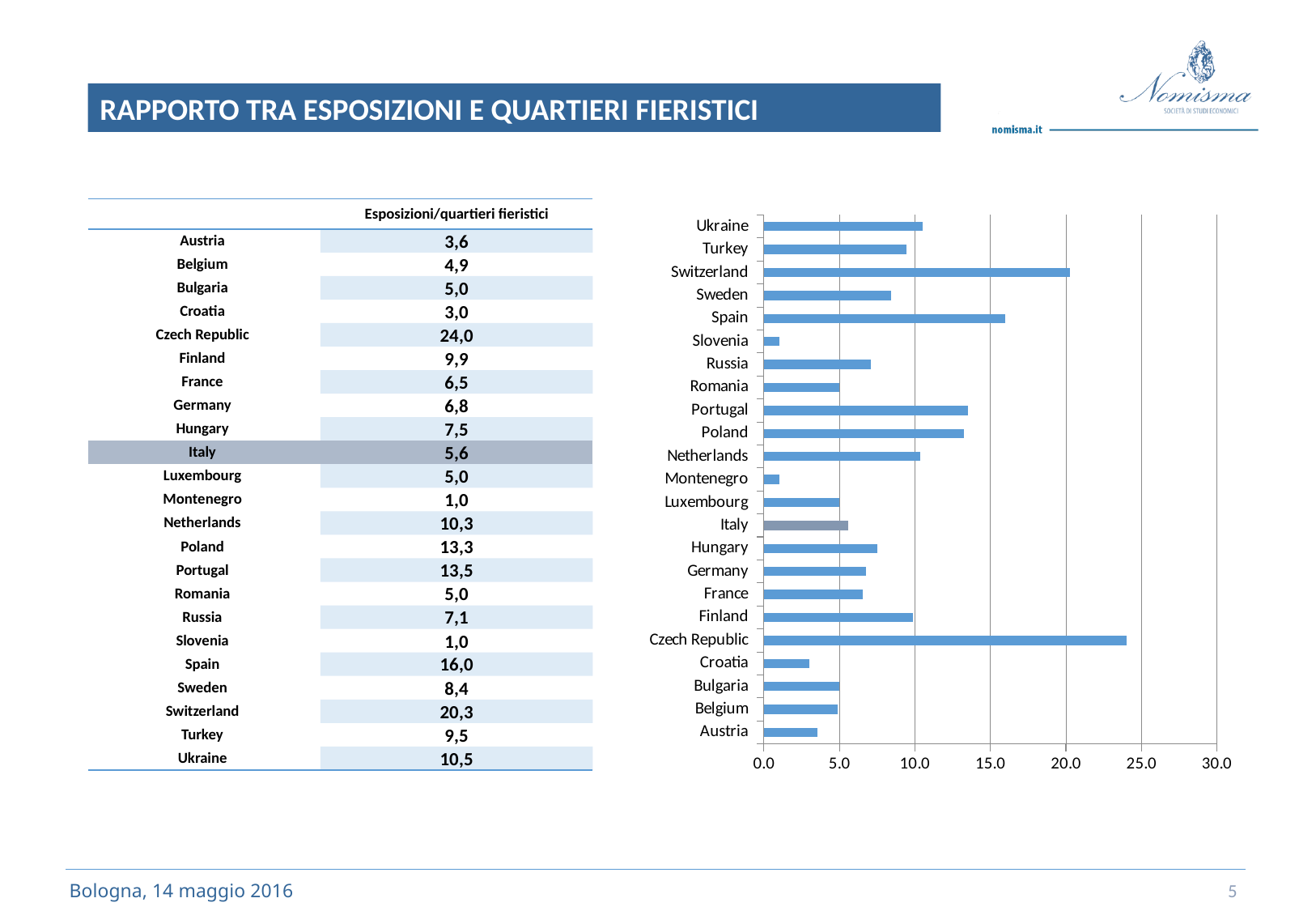
Which country has the highest value in the bar chart? Czech Republic What is the difference between the values for Switzerland and Spain? 4,3 What is the value for Italy? 5,6 What is the value for Czech Republic? 24,0 How many countries are plotted in the bar chart? 23 Is the value for Croatia greater or less than 5.0? less What is the value for Switzerland? 20,3 Which country's bar is shown in a different colour (grey) from the others? Italy What is the maximum value shown on the horizontal axis of the bar chart? 30.0 Is the value for Netherlands greater or less than 10.0? greater What kind of chart is shown on the slide? bar chart Which is larger, the value for Spain or the value for Portugal? Spain